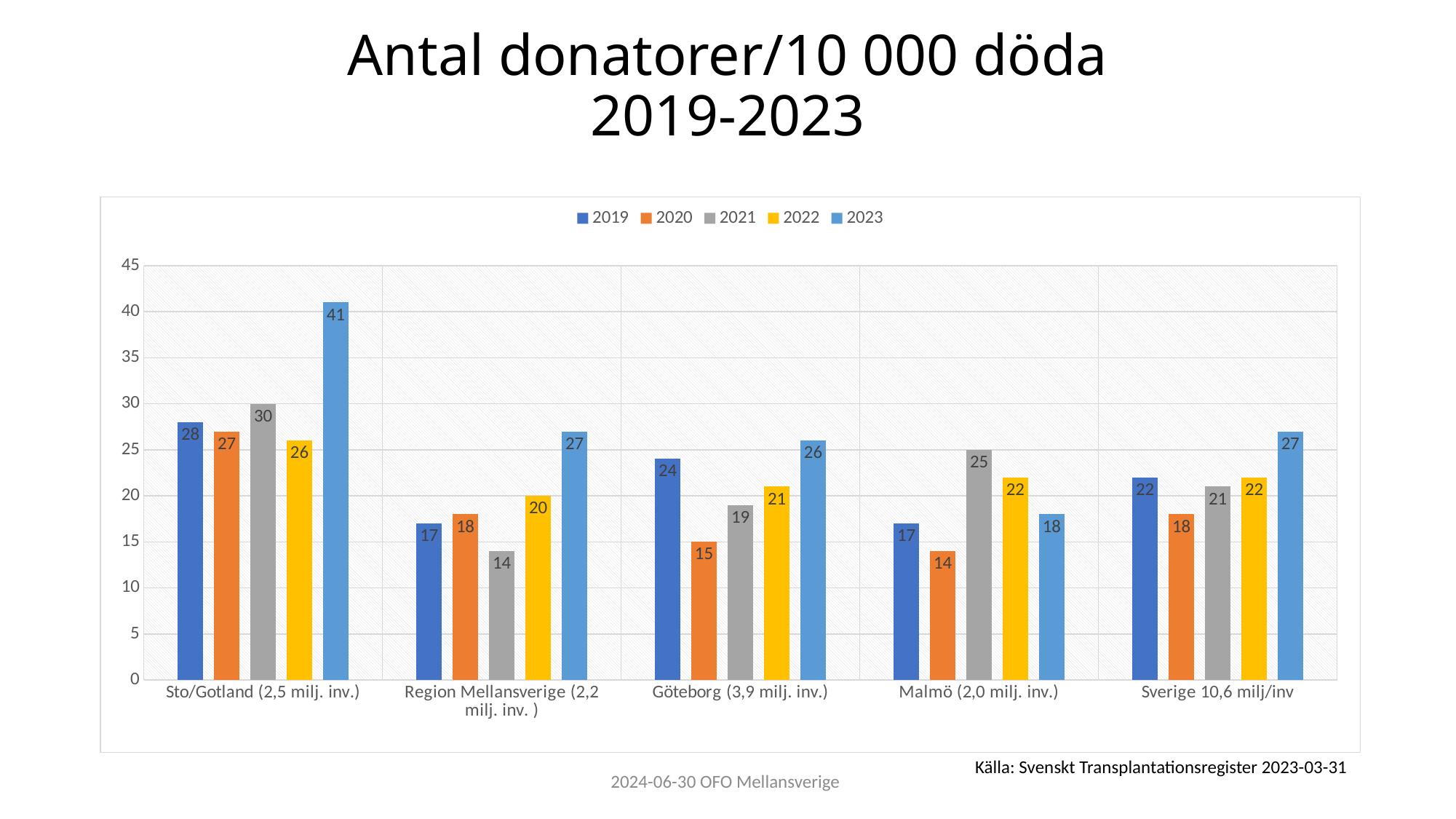
What kind of chart is shown on the slide? Bar chart How many categories are shown on the x axis? 5 Which category has the lowest value in 2021? Region Mellansverige (2,2 milj. inv. ) What is the value for Sverige 10,6 milj/inv in 2019? 22 What is the value for Göteborg (3,9 milj. inv.) in 2020? 15 Which category has the highest value in 2023? Sto/Gotland (2,5 milj. inv.) What is the value for Malmö (2,0 milj. inv.) in 2021? 25 What is the difference between the 2023 and 2019 values for Region Mellansverige (2,2 milj. inv. )? 10 Which is larger for Malmö (2,0 milj. inv.): the 2021 value or the 2023 value? 2021 What is the value for Sto/Gotland (2,5 milj. inv.) in 2023? 41 What is the title of the chart? Antal donatorer/10 000 döda 2019-2023 How many series does the legend list? 5